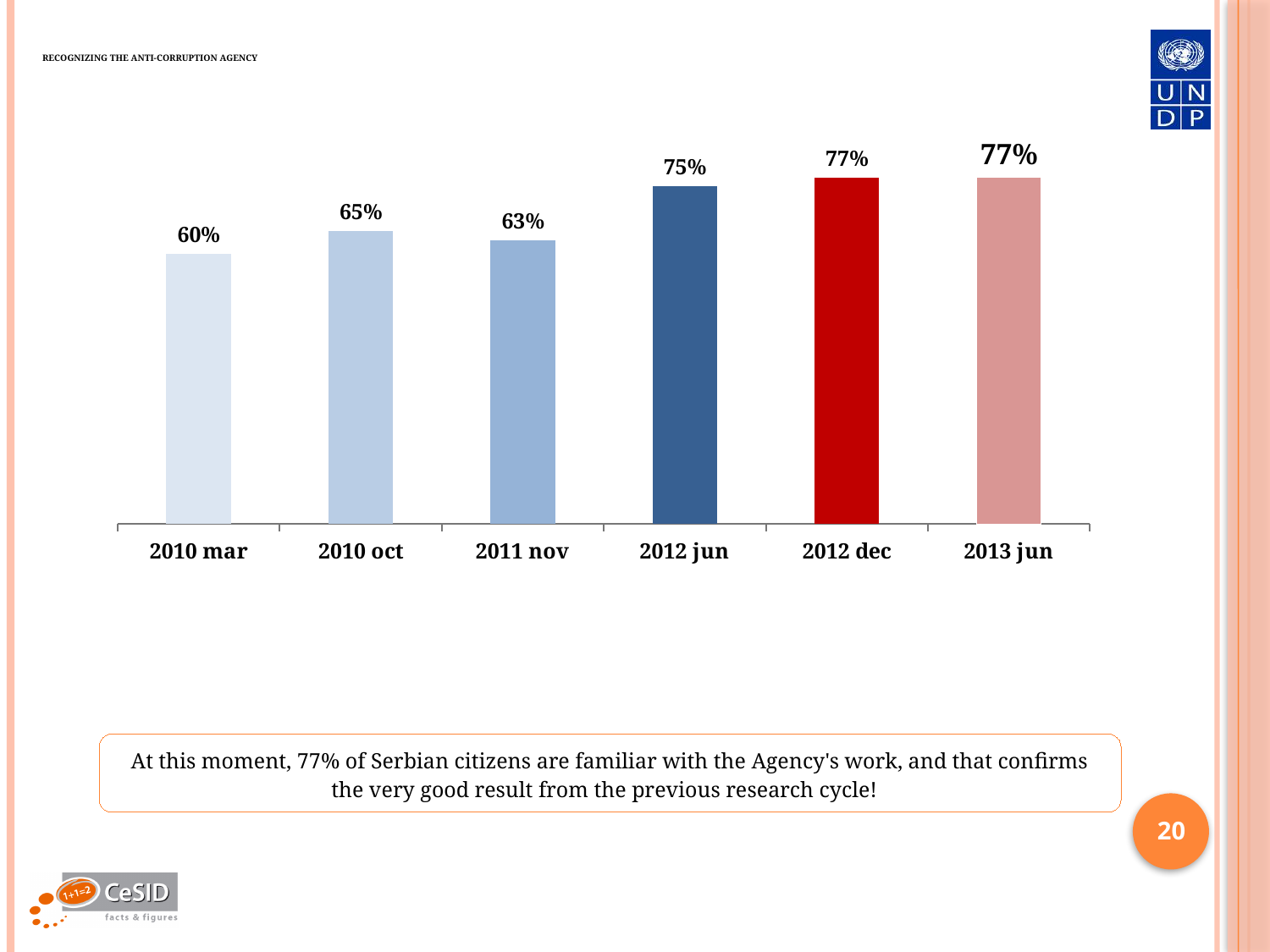
What is the value for 2010 mar? 60% How many categories are shown on the x axis? 6 What is the value for 2011 nov? 63% What is the value for 2010 oct? 65% What is the difference between the values for 2010 oct and 2011 nov? 2% What colour is the bar for 2012 dec? red What is the value for 2012 jun? 75% Which is larger, the value for 2010 oct or the value for 2011 nov? 2010 oct Which category has the lowest value? 2010 mar What is the value for 2013 jun? 77% What kind of chart is shown on the slide? bar chart What is the difference between the values for 2012 jun and 2010 mar? 15%